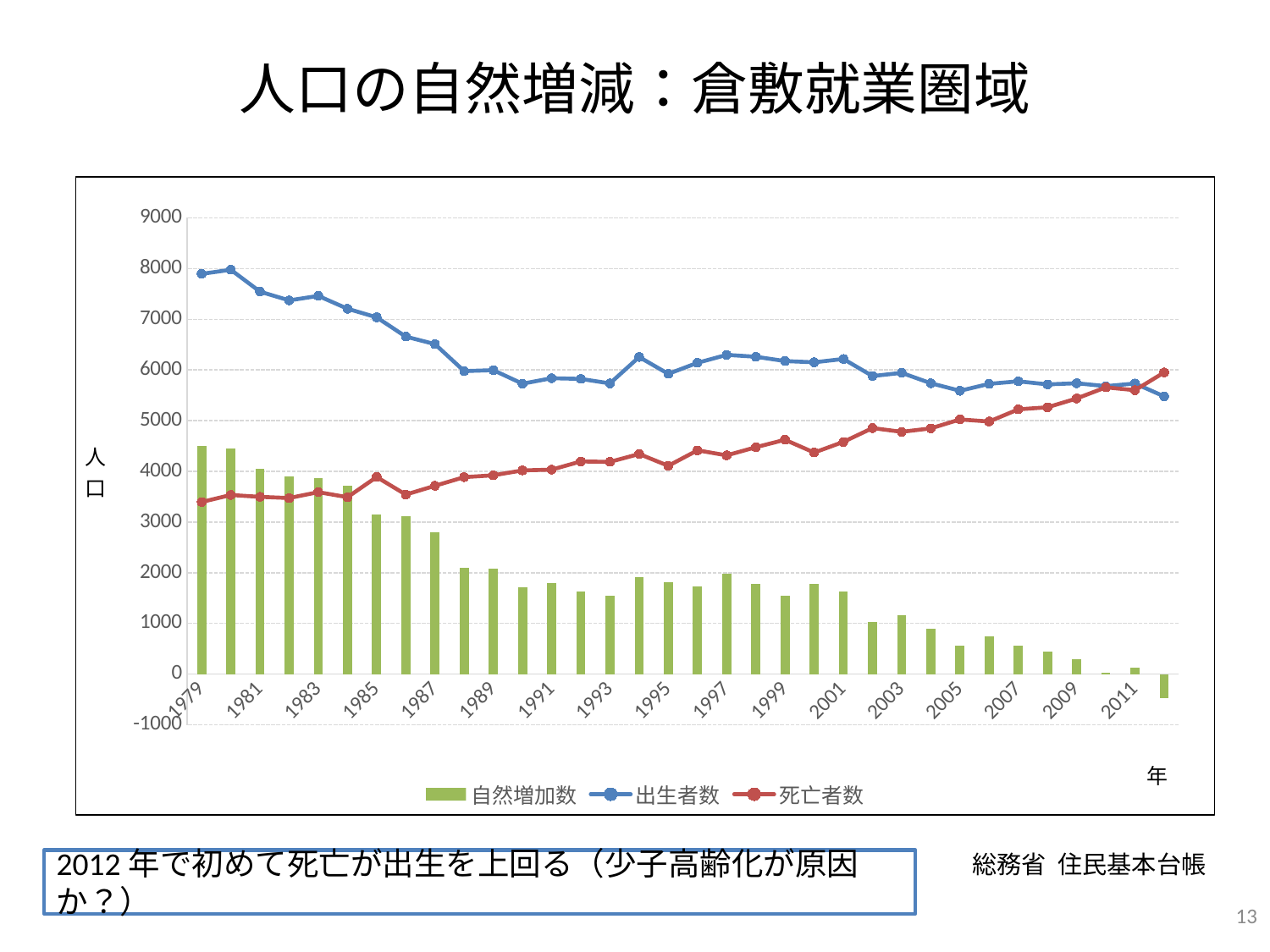
What are the three series listed in the legend? 自然増加数, 出生者数, 死亡者数 Is the value of 死亡者数 in 1979 greater or less than 4000? less Does the 死亡者数 line generally rise or fall from 1979 to 2012? Rise Is the value of 出生者数 in 1979 greater or less than 7000? greater Is the value of 自然増加数 in 2005 greater or less than 1000? less What is the title of the chart on the slide? 人口の自然増減：倉敷就業圏域 What kind of chart is shown on the slide? A combined bar and line chart In which year is 死亡者数 at its highest? 2012 Does the 出生者数 line generally rise or fall from 1979 to 2012? Fall How many series does the legend list? 3 In 1979, which is larger, 出生者数 or 死亡者数? 出生者数